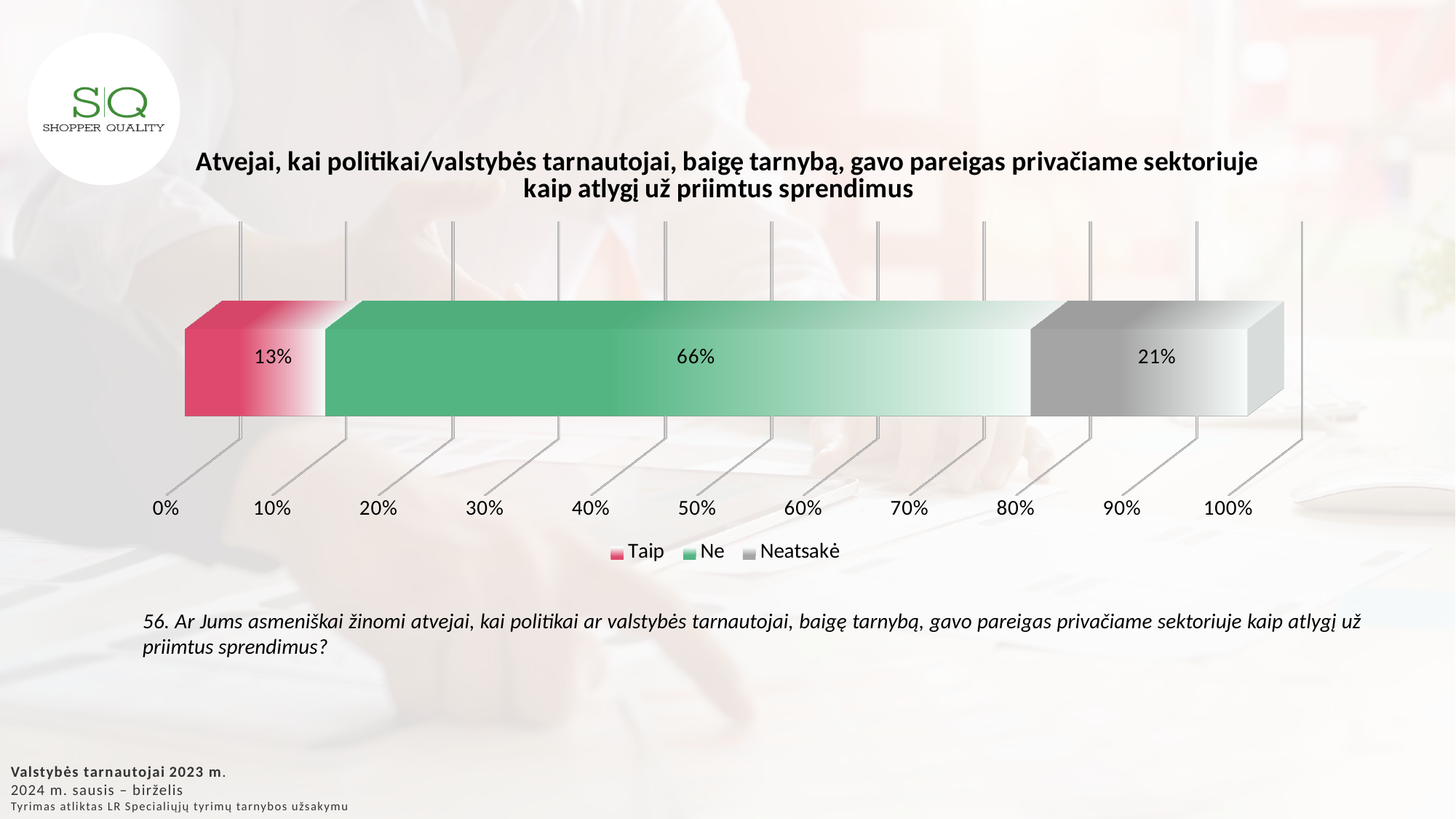
What is the total of the stacked bar? 100% What colour represents the "Ne" series? Green What is the value for "Neatsakė"? 21% What is the difference between the values for "Neatsakė" and "Taip"? 8% What is the value for "Ne"? 66% Which series has the highest value? Ne Which is larger, the value for "Taip" or the value for "Neatsakė"? Neatsakė What is the difference between the values for "Ne" and "Neatsakė"? 45% What is the value for "Taip"? 13% What kind of chart is shown on the slide? Stacked bar chart Which series has the lowest value? Taip How many series does the legend list? 3